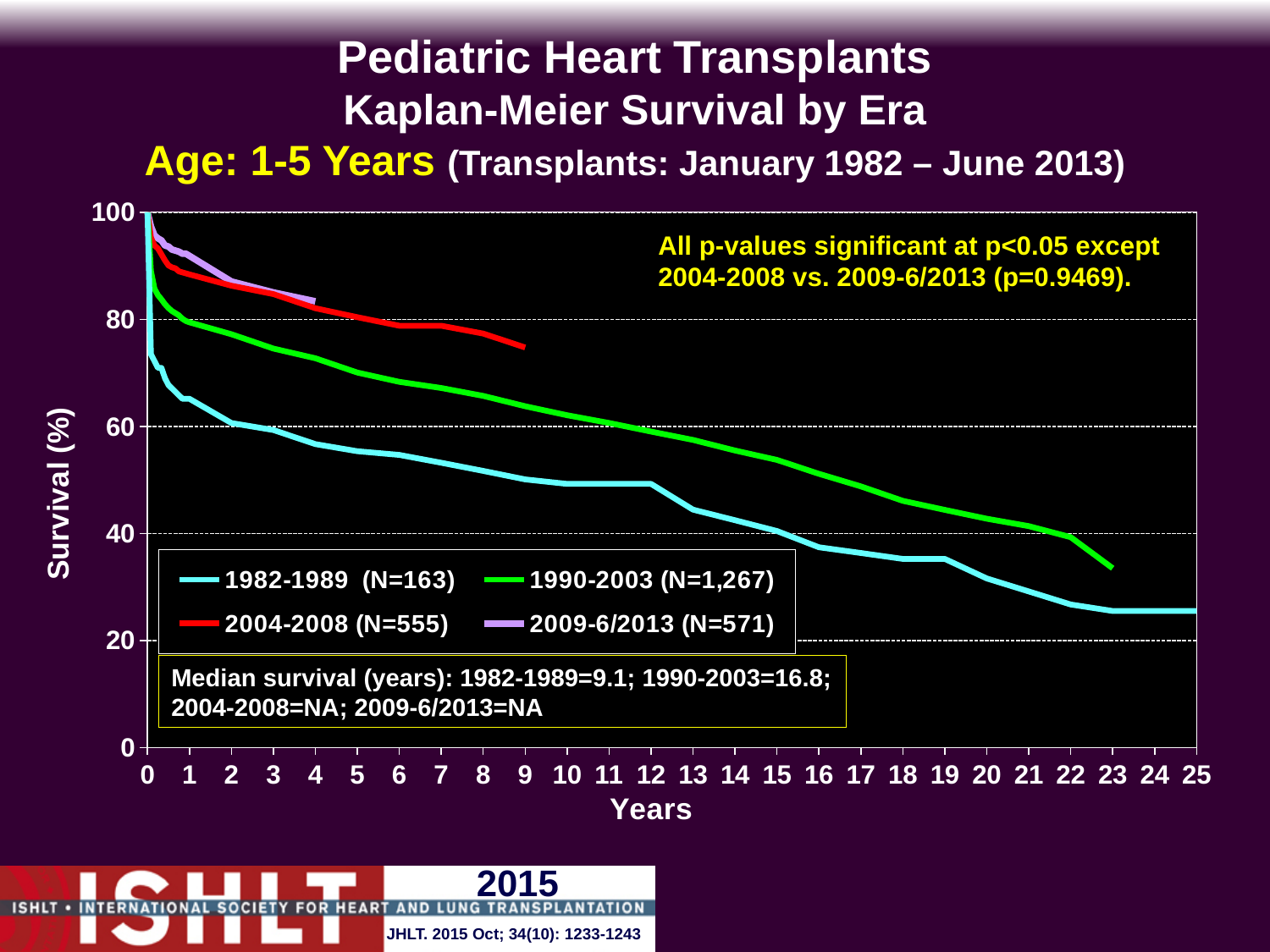
At 5 years, which era has higher survival, 1982-1989 or 1990-2003? 1990-2003 Which era has the lowest survival at 3 years? 1982-1989 Do the survival curves rise or fall as years increase? fall How many series does the legend list? 4 Is the survival for the 1990-2003 era at 5 years greater or less than 60? greater Is the survival for the 1982-1989 era at 20 years greater or less than 40? less What kind of chart is shown on the slide? line chart Is the survival for the 2009-6/2013 era at 2 years greater or less than 80? greater What median survival in years is given for the 1982-1989 era? 9.1 According to the legend, what is the N for the 1990-2003 era? N=1,267